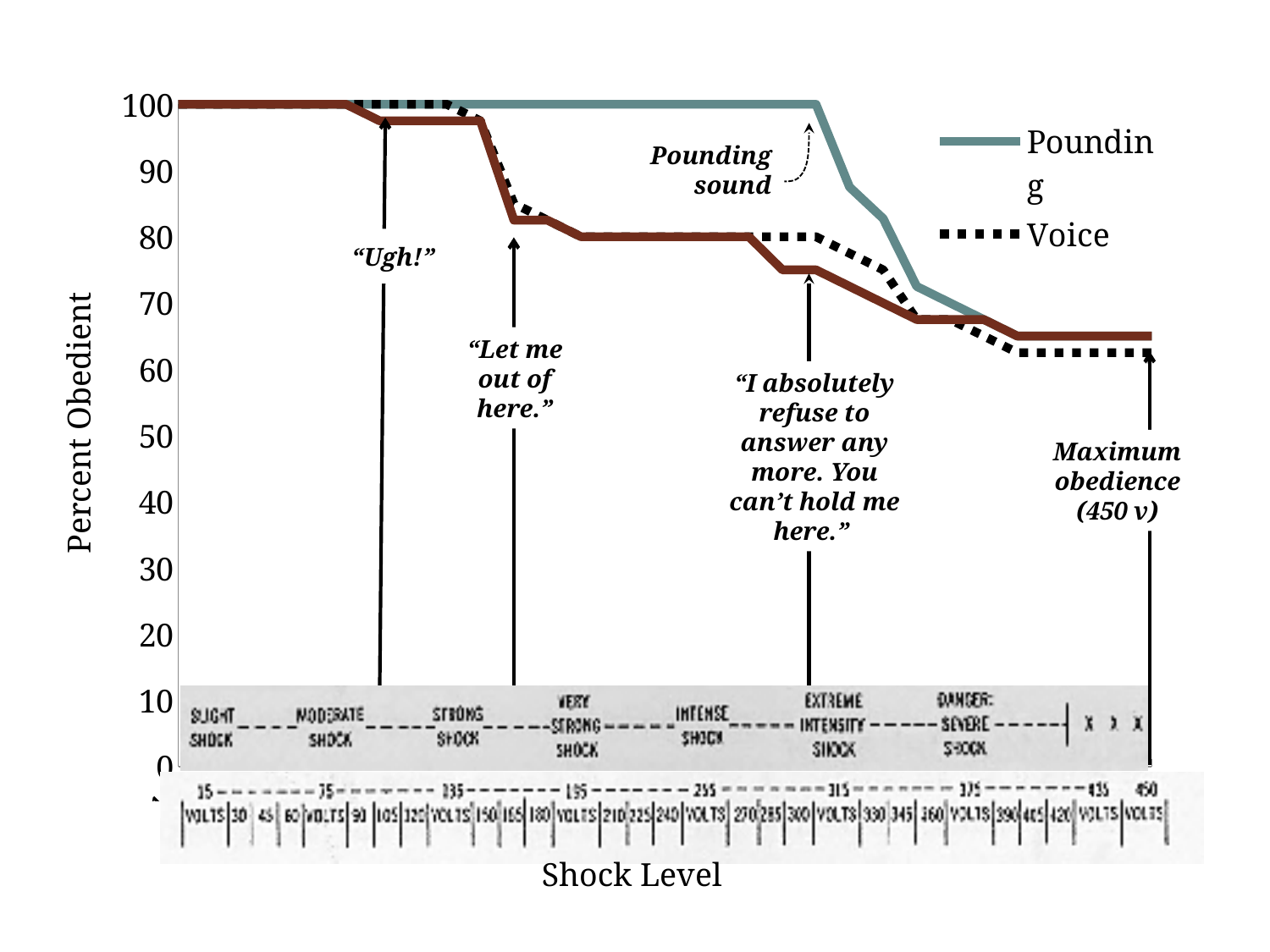
Which legend series has the highest value at 300 volts? Pounding What kind of chart is shown on the slide? line chart Is the value for the Voice series at 450 volts greater or less than 70? less Is the value for the Pounding series at 345 volts greater or less than 90? less Is the value for the Voice series at 240 volts greater or less than 90? less Does the Voice series rise or fall as the shock level increases along the x axis? fall What is the title of the x axis? Shock Level What is the title of the y axis? Percent Obedient At 330 volts, which series has the larger value, Pounding or Voice? Pounding How many series does the legend list? 2